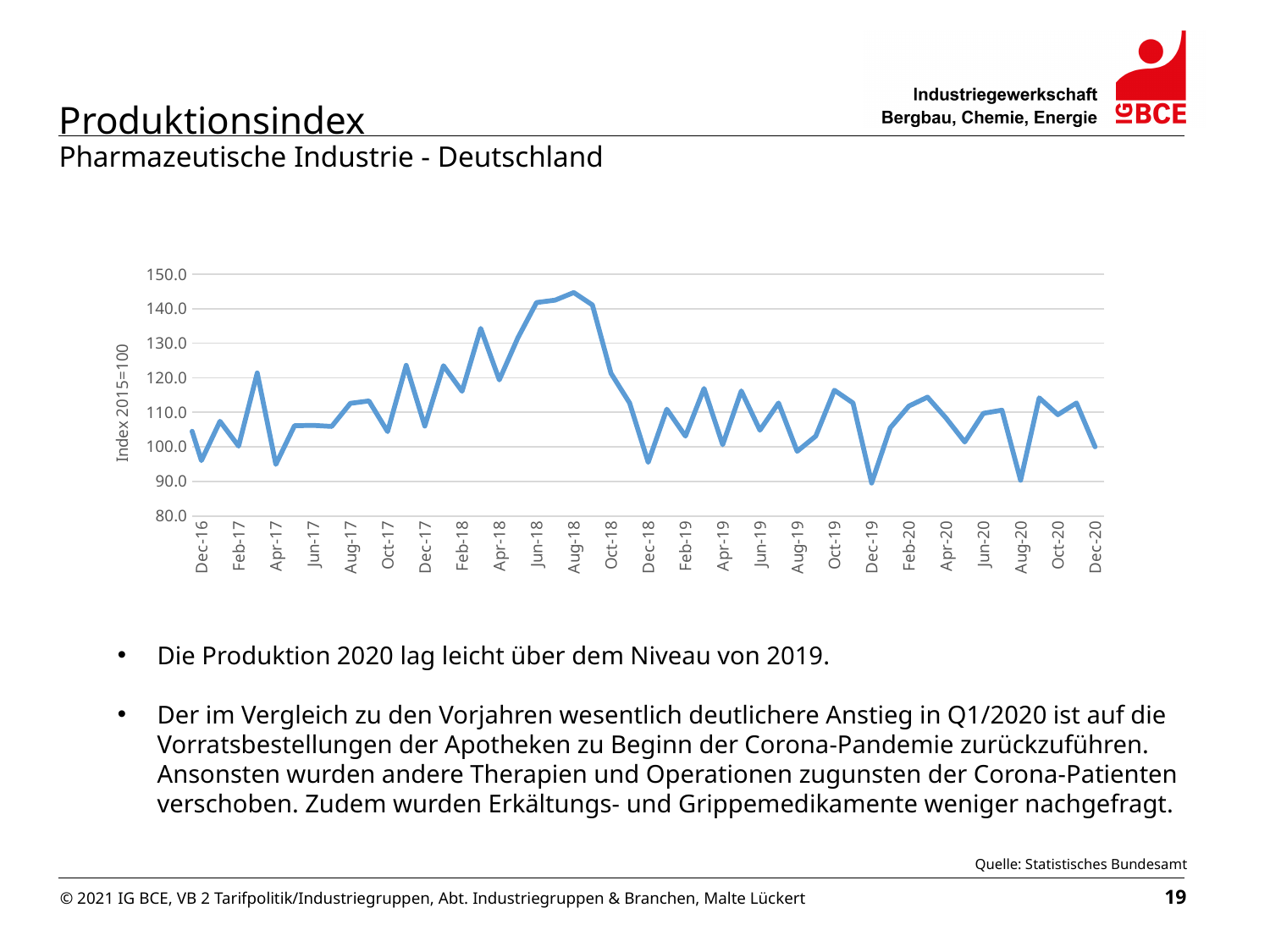
Is the value for Dec-18 greater or less than 100? less What is the first month label on the horizontal axis of the chart? Dec-16 How many month labels are shown on the horizontal axis of the chart? 25 Around which month does the line reach its highest value? Aug-18 Is the value for Apr-17 greater or less than 100? less Is the value for Feb-18 greater or less than 130? less What kind of chart is shown on the slide? line chart What is the label of the vertical axis of the chart? Index 2015=100 Which is larger, the value for Aug-18 or the value for Dec-18? Aug-18 Does the line rise or fall between Apr-18 and Aug-18? rise